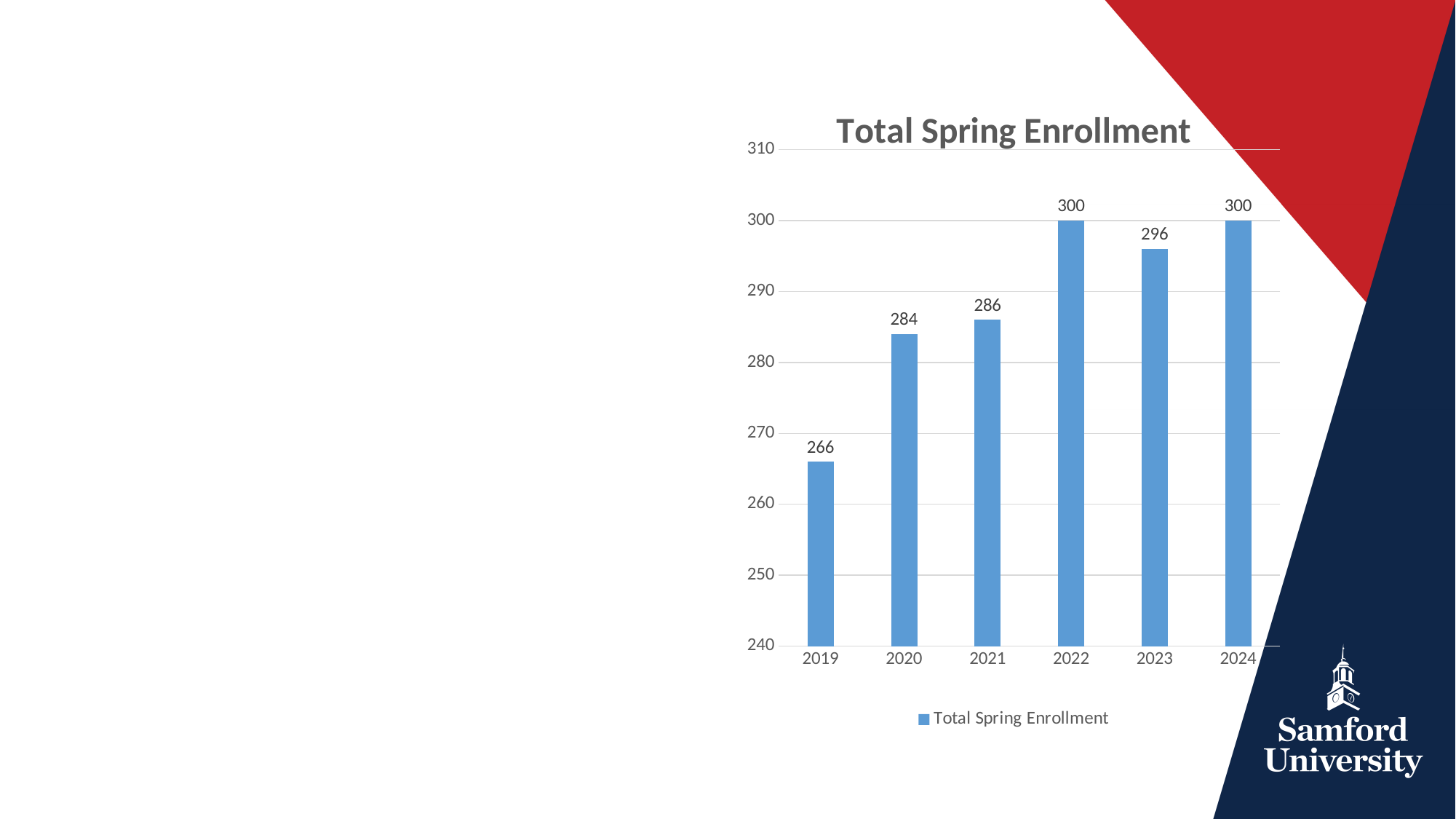
What is the Total Spring Enrollment for 2021? 286 What is the title of the chart? Total Spring Enrollment How many years are shown on the x axis of the chart? 6 How many series does the legend list? 1 What is the difference in Total Spring Enrollment between 2022 and 2019? 34 What is the difference in Total Spring Enrollment between 2023 and 2020? 12 Which year has the lowest Total Spring Enrollment? 2019 What is the Total Spring Enrollment for 2023? 296 What is the Total Spring Enrollment for 2019? 266 Which year has the larger Total Spring Enrollment, 2020 or 2023? 2023 Is the Total Spring Enrollment for 2021 greater or less than 290? less What kind of chart is shown on the slide? bar chart